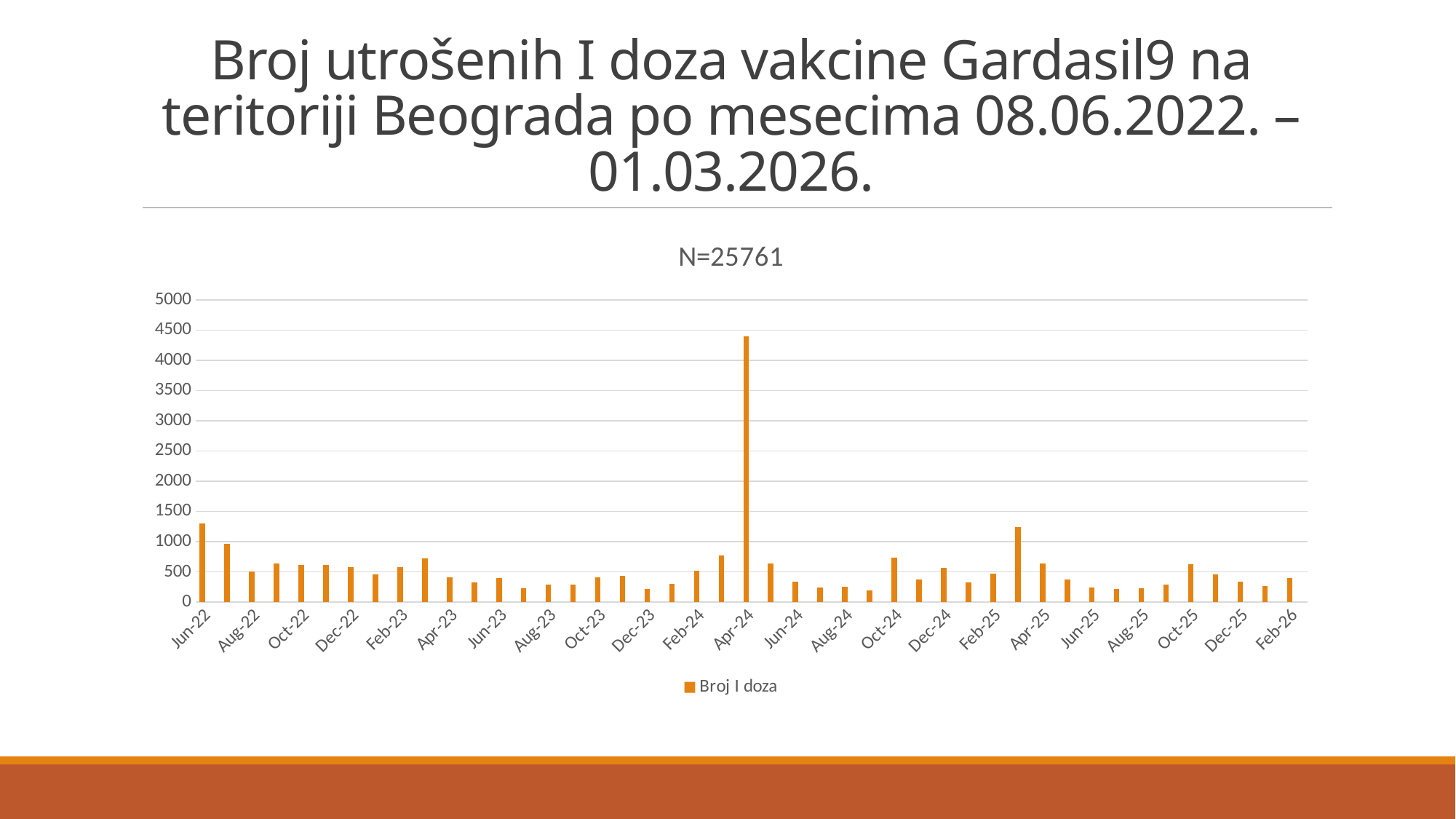
How many series does the legend list? 1 Is the value for Apr-24 greater or less than 5000? less Is the value for Dec-23 greater or less than 500? less Is the value for Jun-22 greater or less than 1000? greater What is the title shown above the chart? N=25761 What is the name of the series in the legend? Broj I doza What kind of chart is shown on the slide? bar chart Which is larger, the value for Oct-25 or the value for Dec-25? Oct-25 Which month has the highest number of first doses? Apr-24 Which is larger, the value for Jun-22 or the value for Aug-22? Jun-22